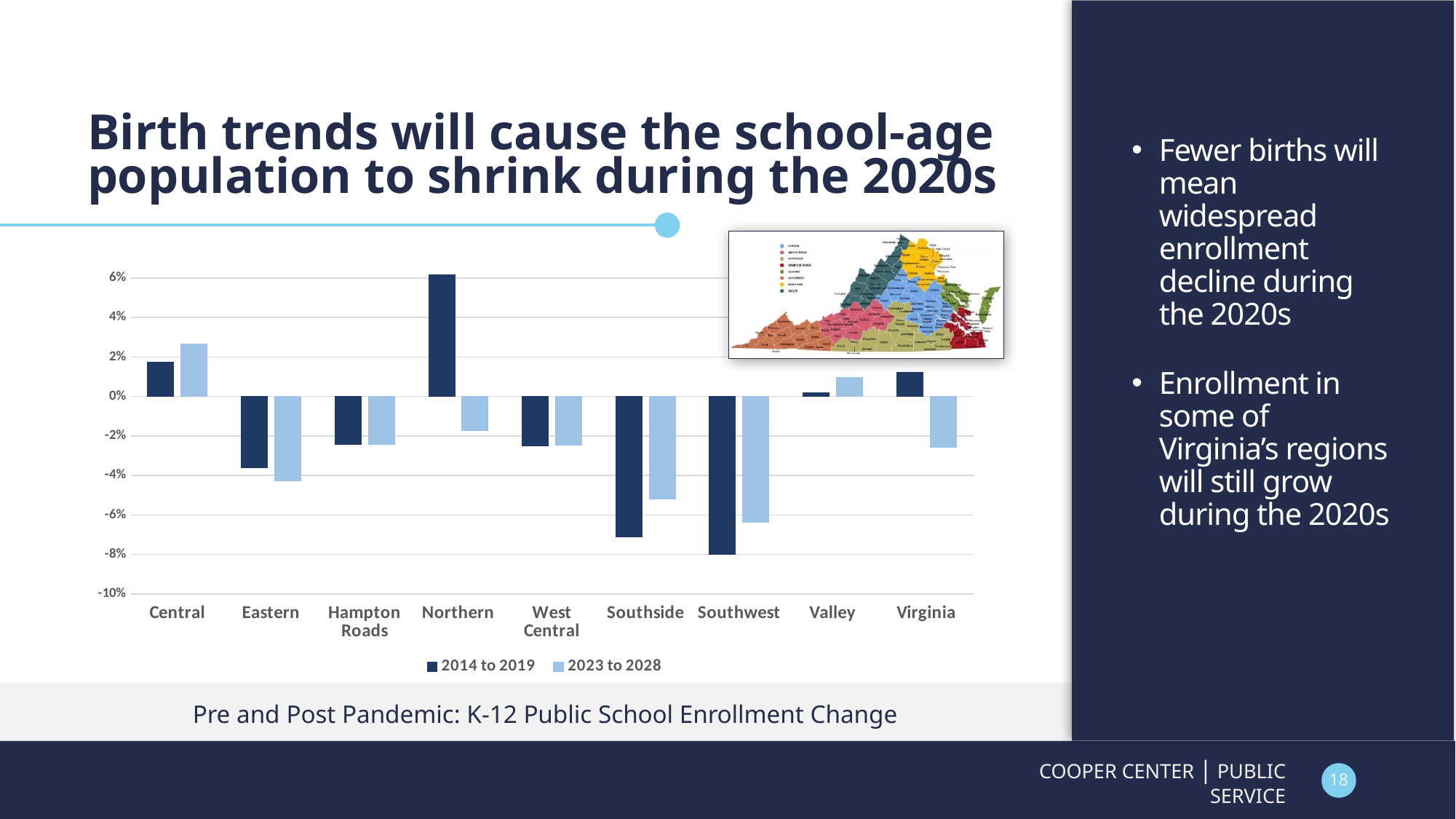
Is the 2014 to 2019 value for Southwest greater or less than -6%? less Which region has the lowest value for the 2014 to 2019 series? Southwest Which region has the lowest value for the 2023 to 2028 series? Southwest Is the 2014 to 2019 value for Northern greater or less than 4%? greater How many regions (categories) are shown on the x axis of the chart? 9 What kind of chart is shown on the slide? bar chart What is the caption/title given below the chart? Pre and Post Pandemic: K-12 Public School Enrollment Change How many series does the chart's legend list? 2 Which region has the highest value for the 2023 to 2028 series? Central Which region has the highest value for the 2014 to 2019 series? Northern For Northern, which series has the larger value: 2014 to 2019 or 2023 to 2028? 2014 to 2019 Is the 2023 to 2028 value for Southside greater or less than -4%? less